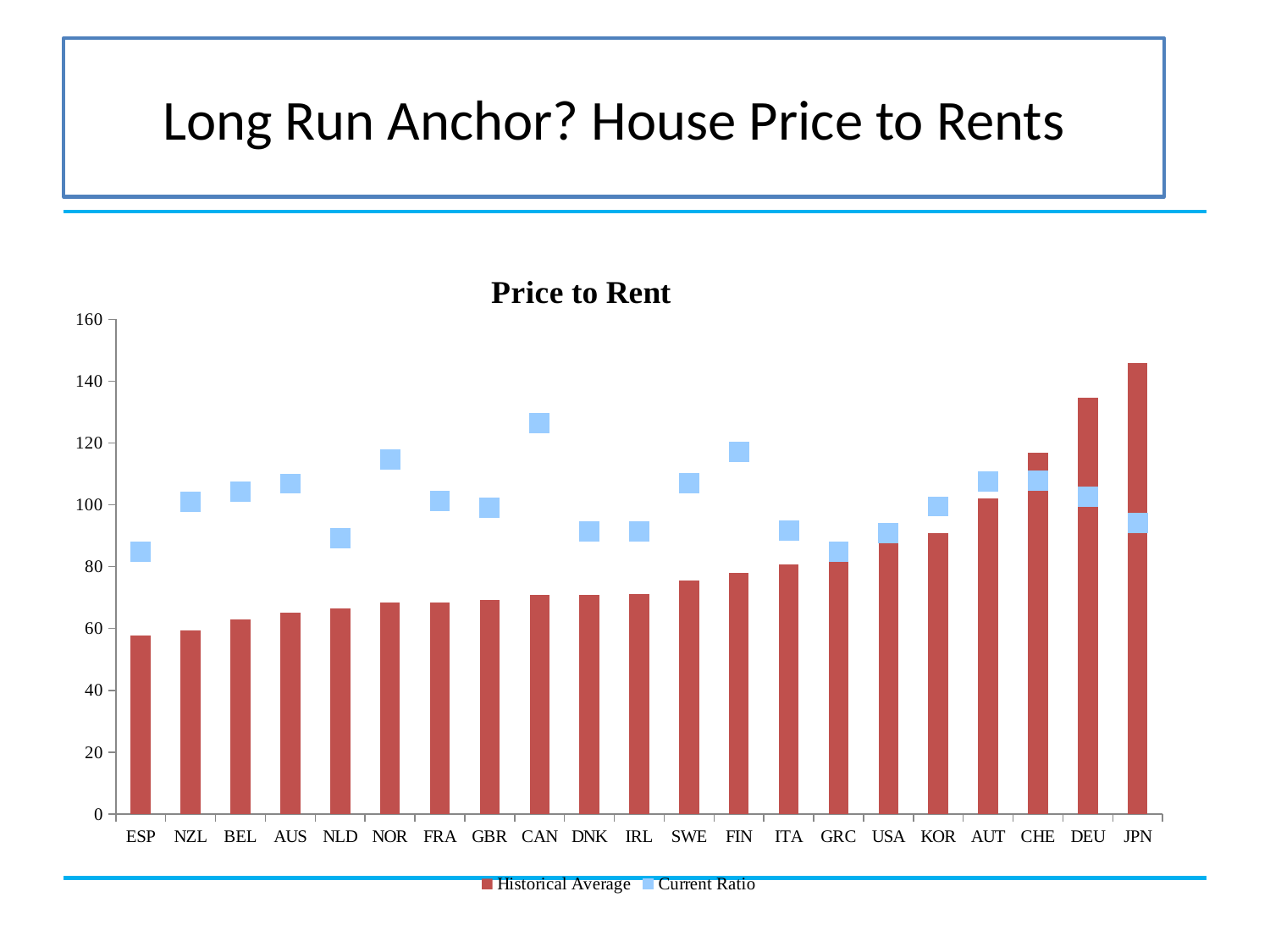
Which country has the highest Historical Average? JPN Which is larger, the Current Ratio for CAN or the Current Ratio for JPN? CAN What kind of chart is shown on the slide? bar chart Is the Current Ratio for NLD greater or less than 100? less Which country has the highest Current Ratio? CAN What is the title of the chart? Price to Rent Is the Historical Average for JPN greater or less than 140? greater Do the Historical Average bars rise or fall from left to right along the x axis? rise How many series does the legend list? 2 Which country has the lowest Historical Average? ESP How many countries are shown on the x axis? 21